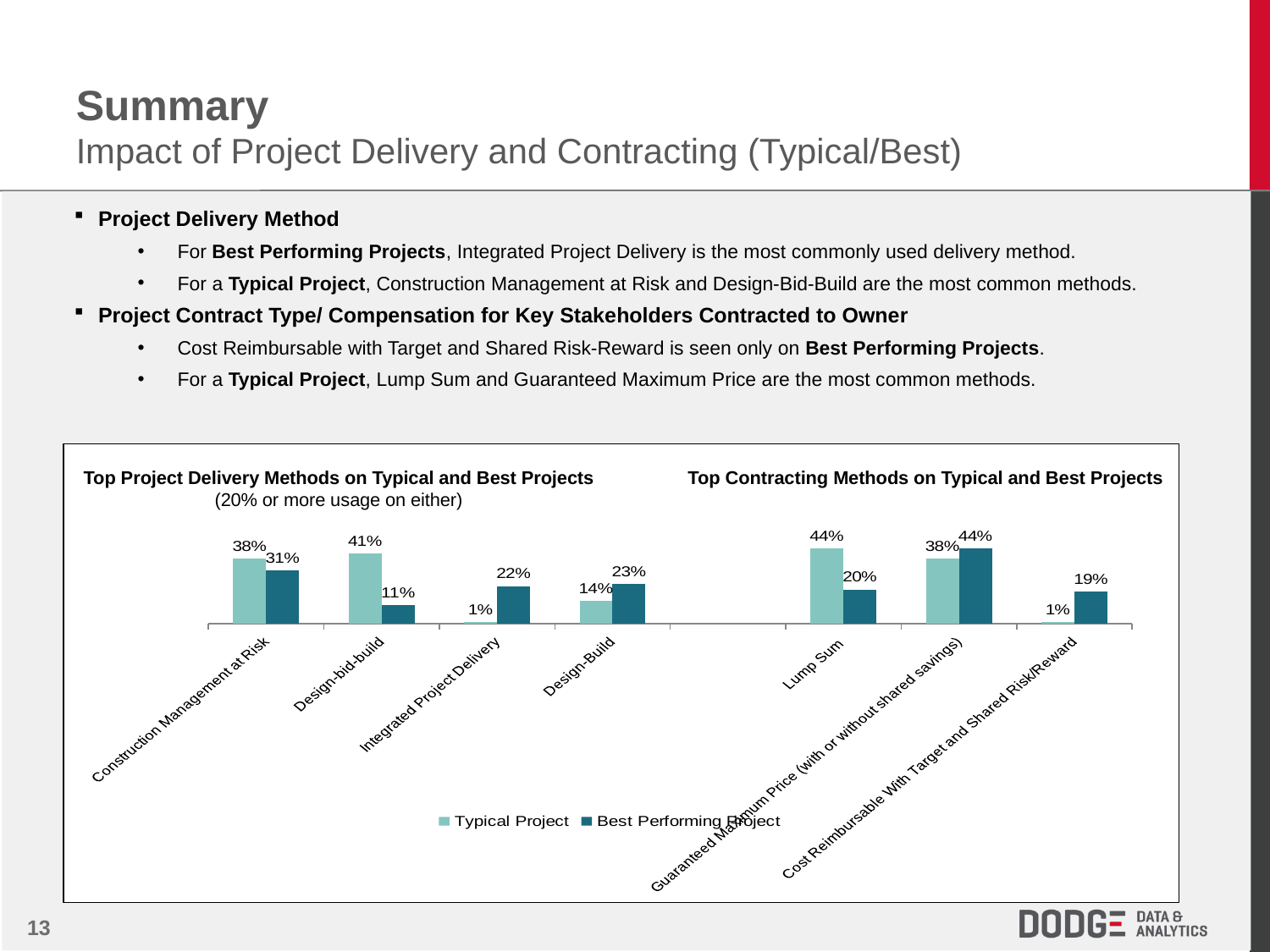
What is the Best Performing Project value for Integrated Project Delivery? 22% What is the difference between the Typical Project and Best Performing Project values for Design-bid-build? 30% What is the Best Performing Project value for Cost Reimbursable With Target and Shared Risk/Reward? 19% What is the Typical Project value for Lump Sum in the Top Contracting Methods section? 44% How many series does the legend list? 2 Among the Top Contracting Methods, which category has the lowest Typical Project value? Cost Reimbursable With Target and Shared Risk/Reward What is the difference between the Typical Project and Best Performing Project values for Lump Sum? 24% How many categories are shown in the Top Contracting Methods section? 3 Among the Top Project Delivery Methods, which category has the highest Typical Project value? Design-bid-build For Guaranteed Maximum Price, which is larger: the Typical Project value or the Best Performing Project value? Best Performing Project What is the Typical Project value for Design-bid-build in the Top Project Delivery Methods section? 41% What kind of chart is shown on the slide? Bar chart